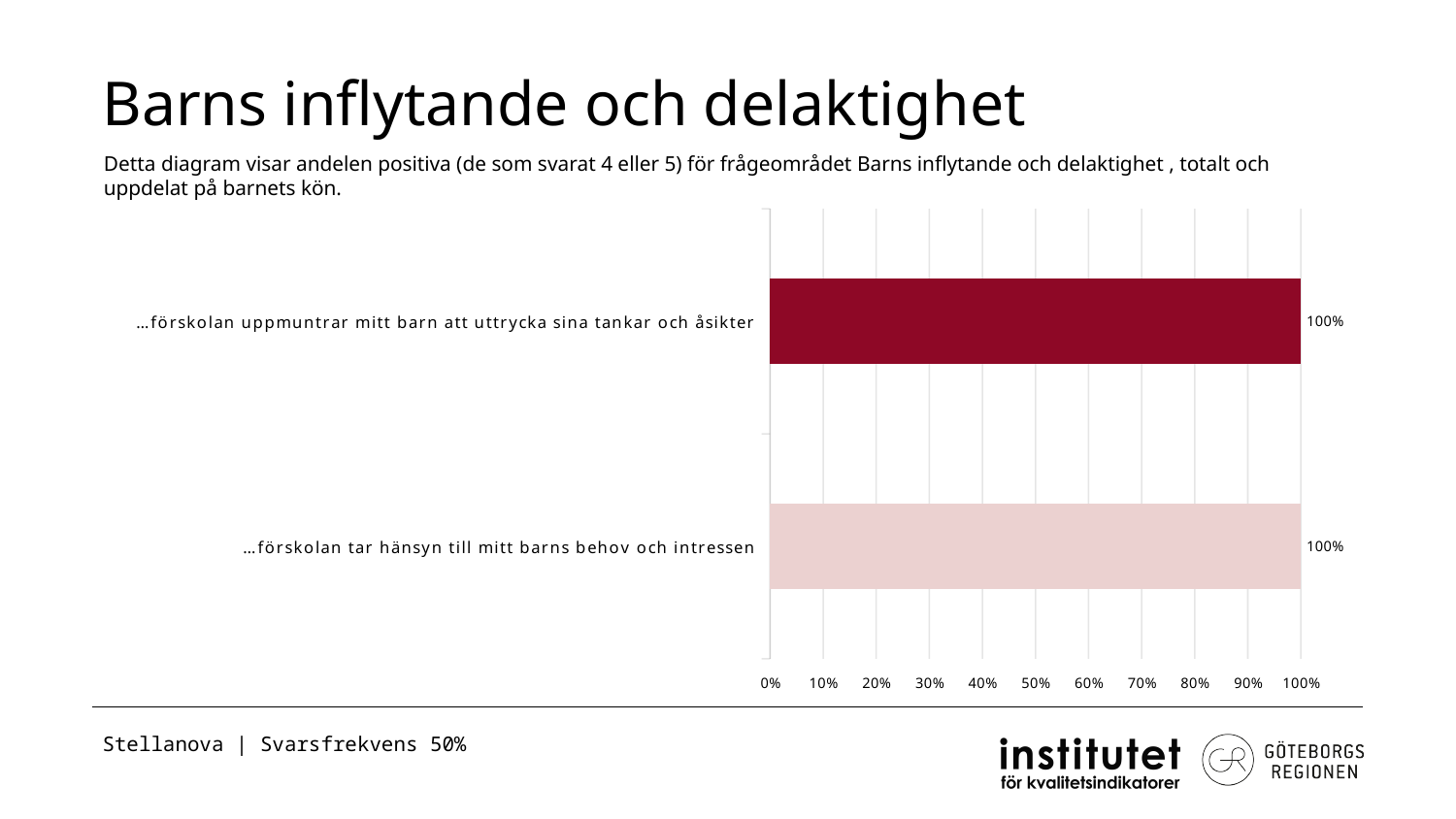
What is the value for "…förskolan uppmuntrar mitt barn att uttrycka sina tankar och åsikter"? 100% Do the two bars in the chart have the same value or different values? The same value What is the highest tick label shown on the horizontal axis? 100% What is the title of the slide containing the chart? Barns inflytande och delaktighet What is the value for "…förskolan tar hänsyn till mitt barns behov och intressen"? 100% What kind of chart is shown on the slide? Bar chart Is the value for "…förskolan uppmuntrar mitt barn att uttrycka sina tankar och åsikter" greater or less than 90%? greater Is the value for "…förskolan tar hänsyn till mitt barns behov och intressen" greater or less than 50%? greater What is the difference between the values for "…förskolan uppmuntrar mitt barn att uttrycka sina tankar och åsikter" and "…förskolan tar hänsyn till mitt barns behov och intressen"? 0% How many categories (bars) are plotted in the chart? 2